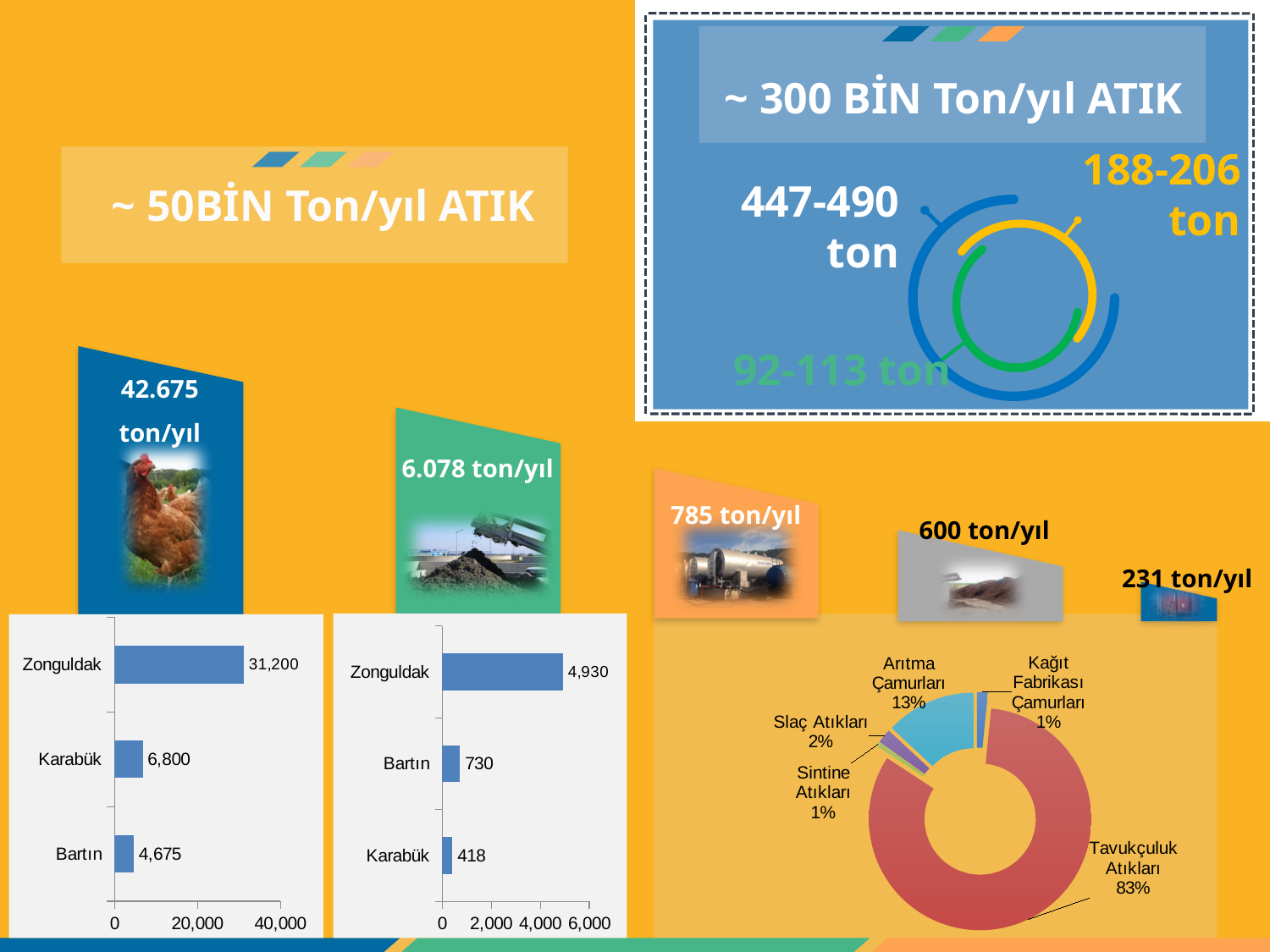
In the left bar chart, what is the value for Zonguldak? 31,200 In the left bar chart, what is the difference between the values for Zonguldak and Bartın? 26,525 How many categories are shown in the middle bar chart? 3 In the middle bar chart, which is larger, the value for Bartın or the value for Karabük? Bartın In the left bar chart, which category has the lowest value? Bartın In the doughnut chart on the right, what share does Arıtma Çamurları have? 13% In the middle bar chart, which category has the highest value? Zonguldak What kind of chart is the chart on the right of the slide? Doughnut chart In the middle bar chart, what is the value for Bartın? 730 In the doughnut chart on the right, what share does Tavukçuluk Atıkları have? 83% In the middle bar chart, what is the difference between the values for Bartın and Karabük? 312 In the left bar chart, what is the value for Karabük? 6,800